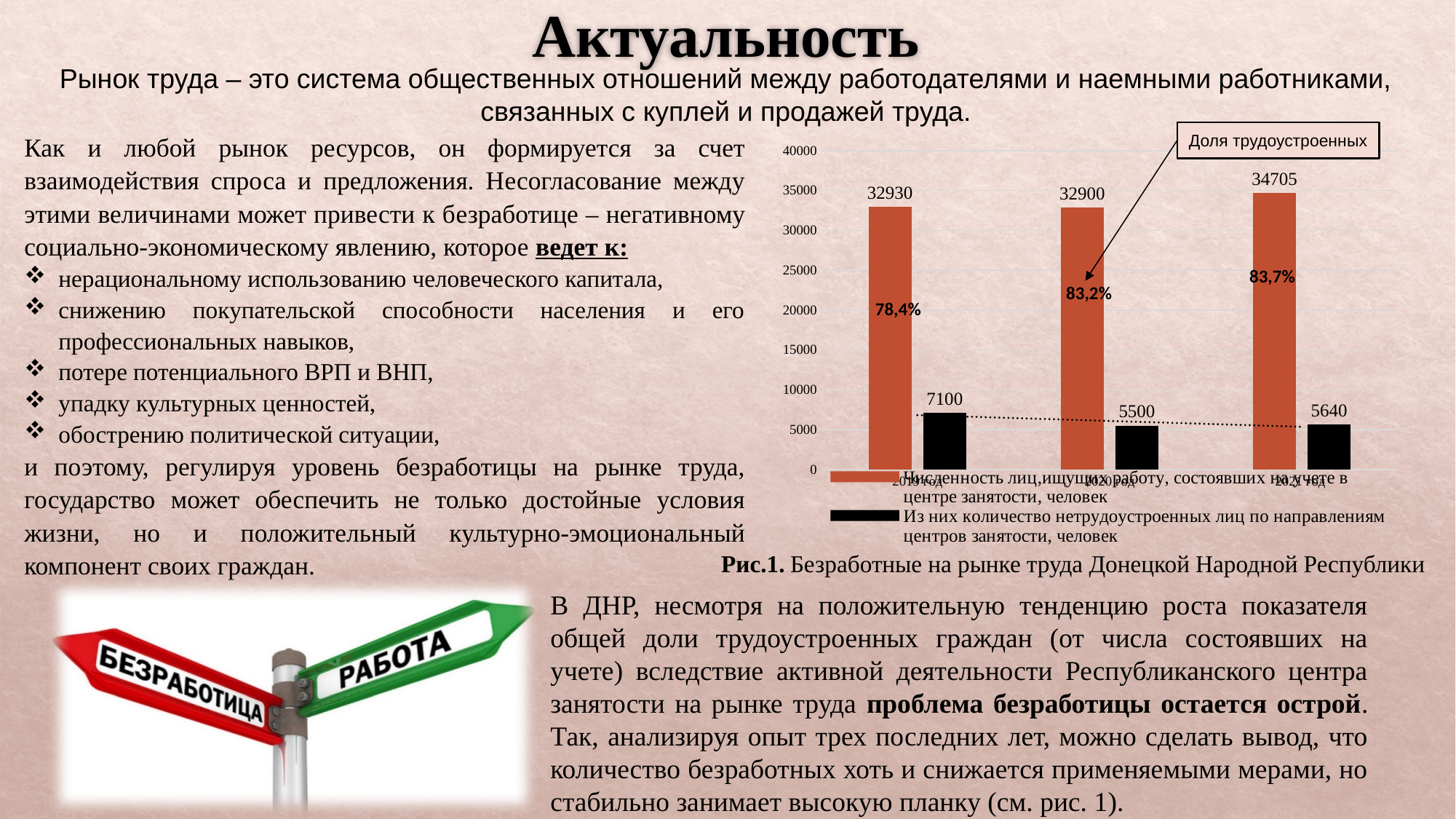
What is the value of the orange bar for 2021 год? 34705 Which year has the lowest value for the black series (количество нетрудоустроенных лиц)? 2020 год Is the black bar for 2019 год greater or less than 5000? greater What is the value of the orange bar (численность лиц, ищущих работу) for 2019 год? 32930 What is the difference between the black bar values for 2019 год and 2021 год? 1460 Does the 'Доля трудоустроенных' percentage rise or fall from 2019 год to 2021 год? rise Which year has the highest value for the orange series (численность лиц, ищущих работу)? 2021 год What is the 'Доля трудоустроенных' percentage shown for 2019 год? 78,4% What kind of chart is shown on the slide? bar chart What is the value of the black bar (количество нетрудоустроенных лиц) for 2020 год? 5500 How many year groups are plotted on the chart? 3 How many series does the chart legend list? 2